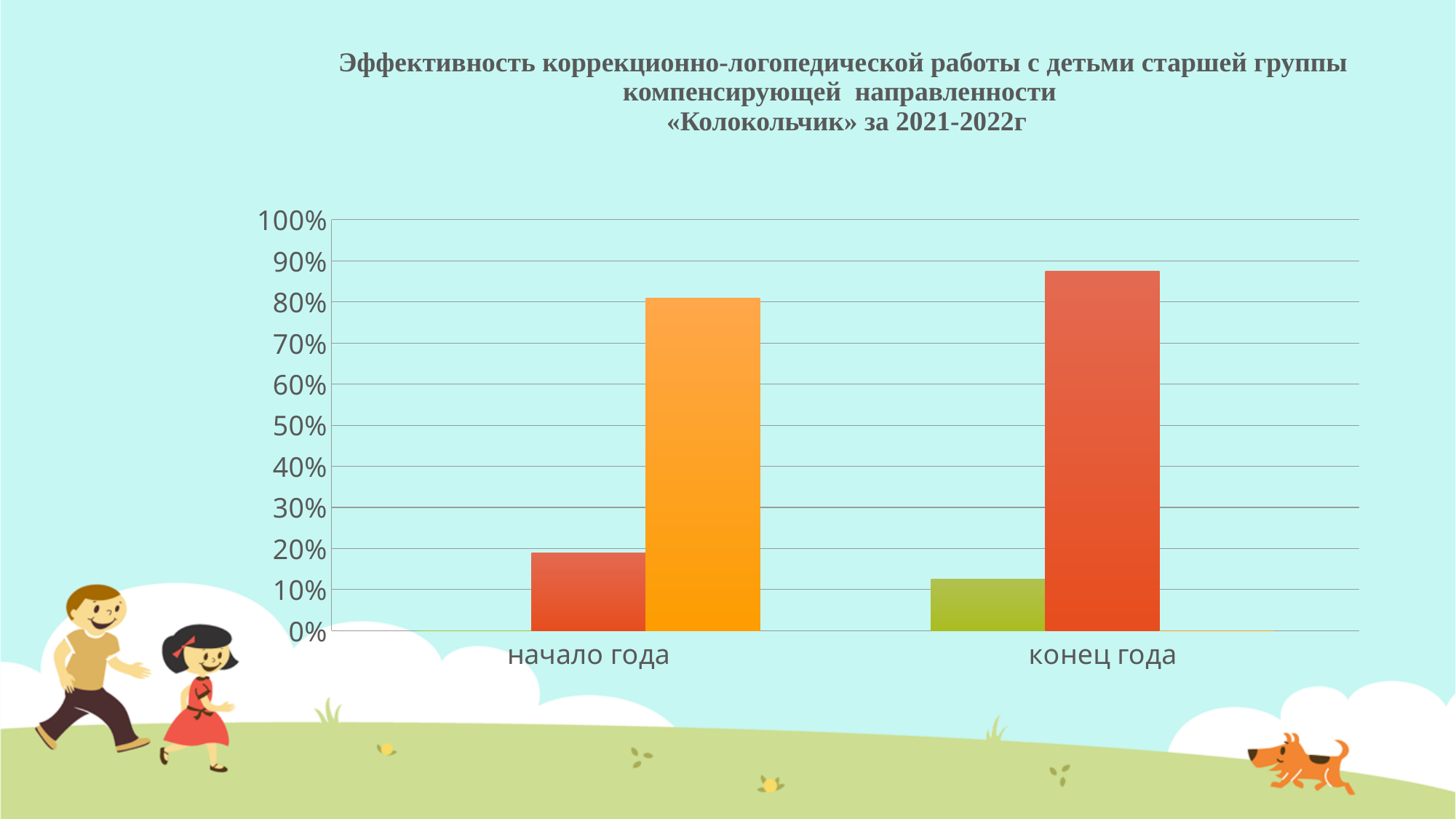
Which category has the tallest bar overall, "начало года" or "конец года"? конец года Is the value of the orange bar for "начало года" greater or less than 70%? greater What is the highest value shown on the y axis of the chart? 100% What are the two category labels on the x axis? начало года, конец года How many categories are shown on the x axis of the chart? 2 Is the value of the red bar for "начало года" greater or less than 30%? less What kind of chart is shown on the slide? bar chart Which is larger: the orange bar for "начало года" or the red bar for "начало года"? the orange bar Which is larger: the green bar for "конец года" or the red bar for "начало года"? the red bar for "начало года" Is the value of the red bar for "начало года" greater or less than 10%? greater